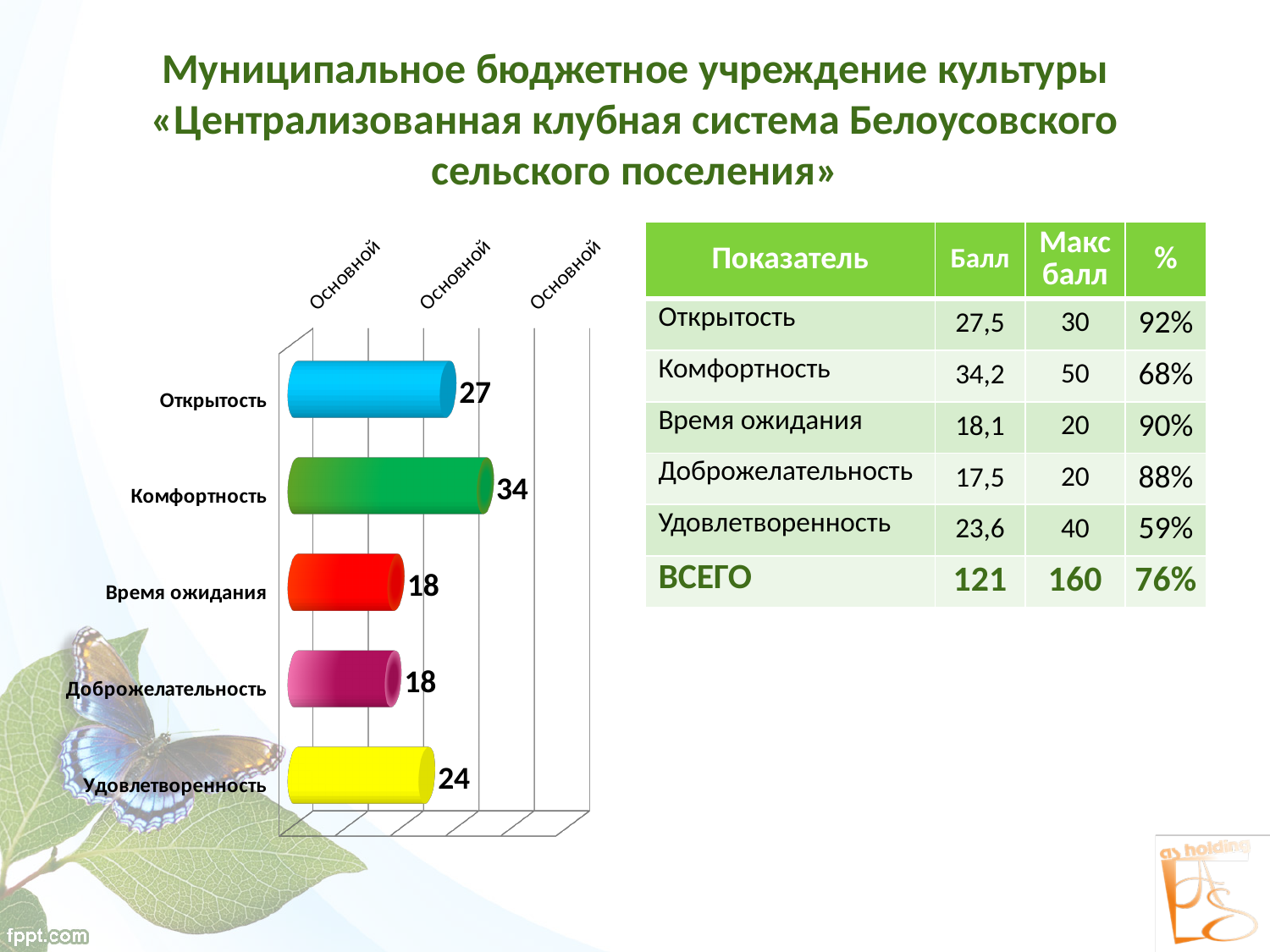
What is the difference between the values for Удовлетворенность and Доброжелательность in the bar chart? 6 What is the difference between the values for Комфортность and Открытость in the bar chart? 7 Which two categories in the bar chart share the same value of 18? Время ожидания and Доброжелательность Which is larger in the bar chart, the value for Открытость or the value for Удовлетворенность? Открытость Which category has the highest value in the bar chart? Комфортность How many categories are plotted in the bar chart? 5 What value is shown for Время ожидания in the bar chart? 18 What value is shown for Удовлетворенность in the bar chart? 24 What value is shown for Открытость in the bar chart? 27 What value is shown for Комфортность in the bar chart? 34 What type of chart is shown on the slide? Bar chart What colour is the bar for Комфортность in the chart? Green